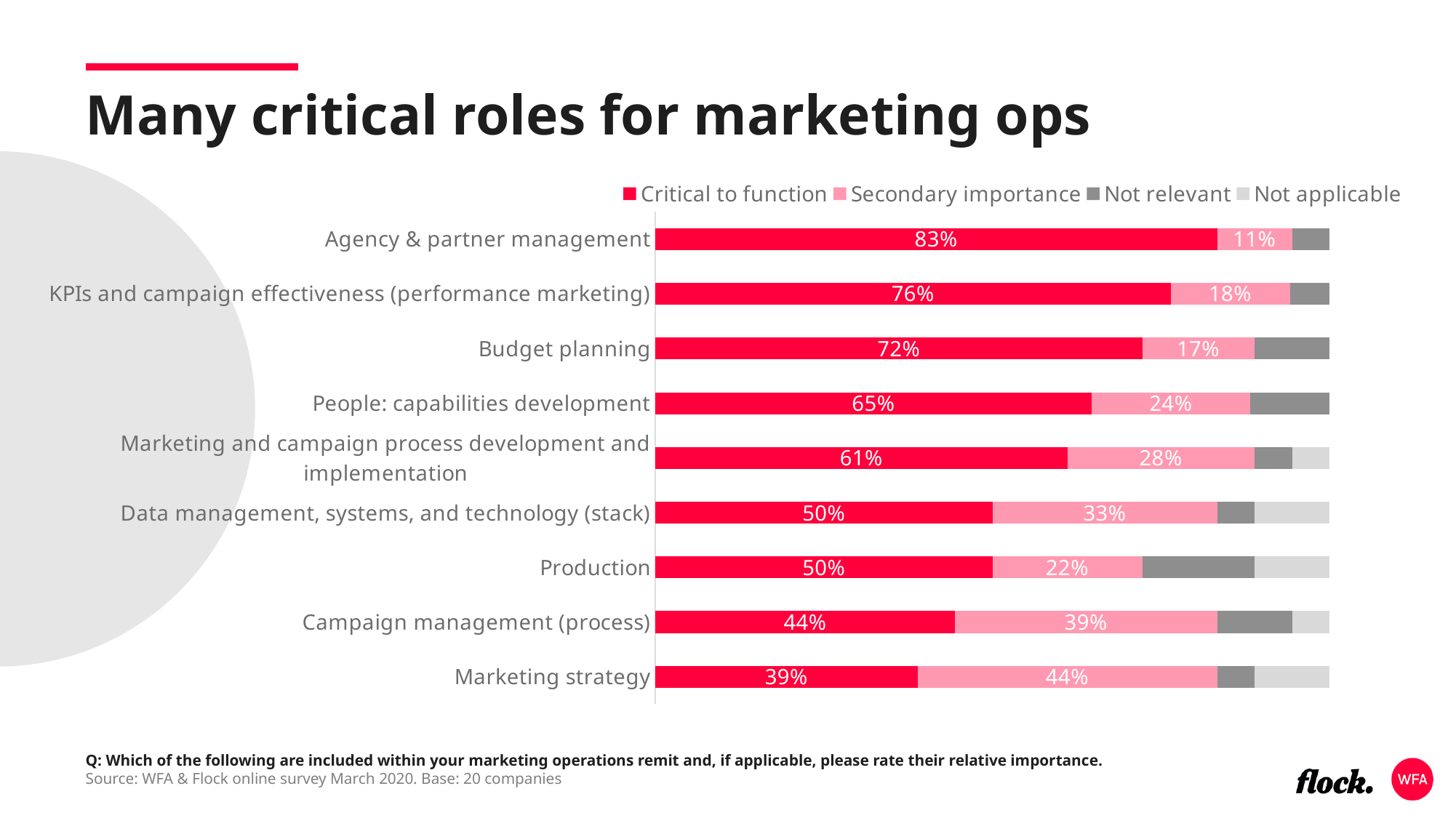
Which has a larger Secondary importance value, Campaign management (process) or Production? Campaign management (process) Which category has the highest Secondary importance percentage? Marketing strategy How many series does the legend list? 4 What is the Critical to function value for Budget planning? 72% Which category has the highest Critical to function percentage? Agency & partner management Which legend entry is shown in the darkest grey colour? Not relevant Which category has the lowest Critical to function percentage? Marketing strategy What kind of chart is shown on the slide? Stacked bar chart What is the Secondary importance value for Marketing strategy? 44% What percentage of respondents rated Agency & partner management as critical to function? 83% How many categories are shown in the chart? 9 What is the difference between the Critical to function values for KPIs and campaign effectiveness (performance marketing) and People: capabilities development? 11%